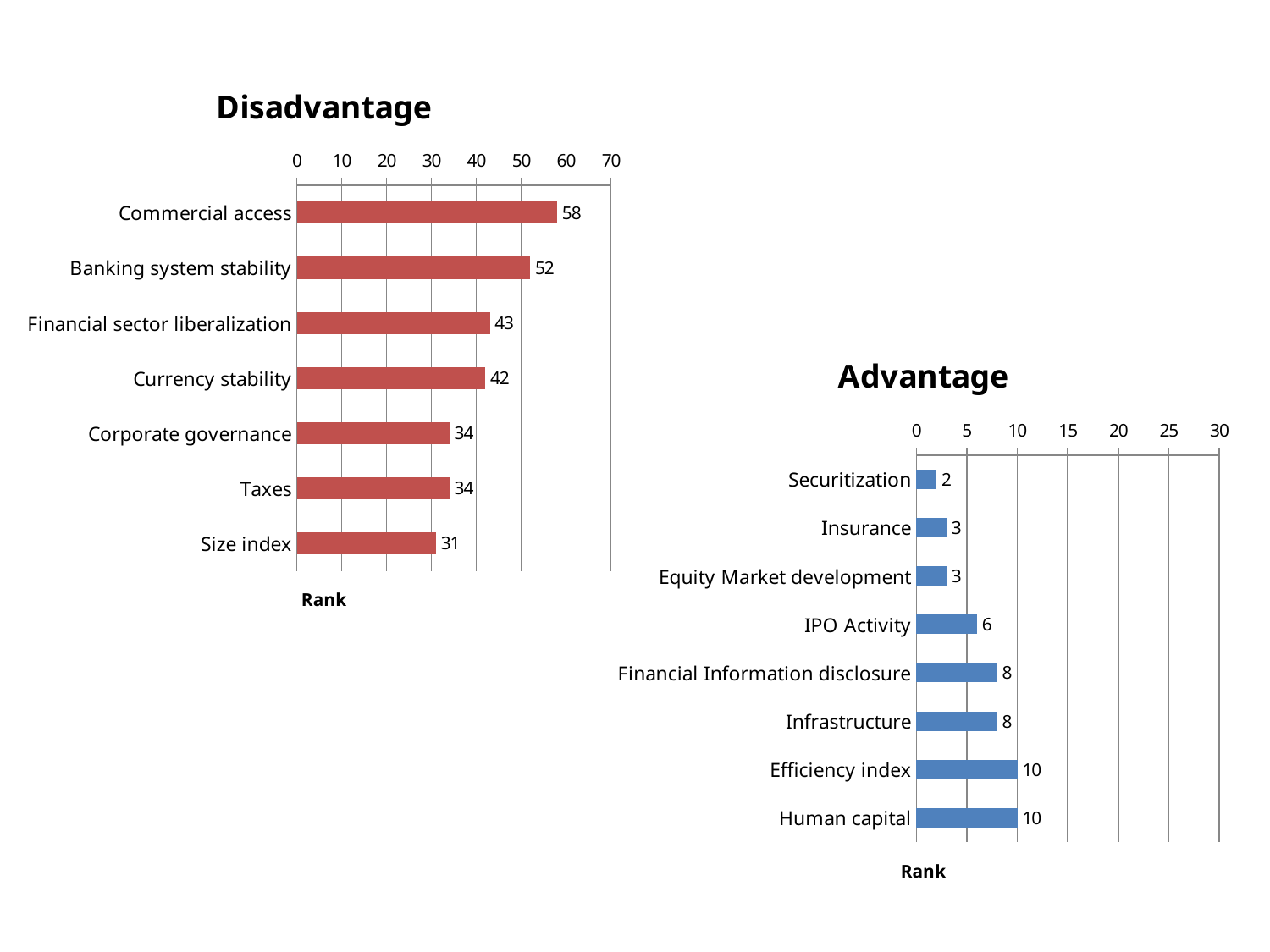
In the Advantage chart, what is the difference between the ranks for Human capital and Securitization? 8 In the Advantage chart, how many categories are shown? 8 In the Advantage chart, which is larger, the rank for Infrastructure or the rank for Insurance? Infrastructure In the Advantage chart, which category has the lowest rank? Securitization In the Disadvantage chart, is the rank for Financial sector liberalization greater or less than 40? greater In the Disadvantage chart, how many categories are shown? 7 What kind of chart is the Advantage chart? Bar chart In the Disadvantage chart, which category has the lowest rank? Size index In the Disadvantage chart, what is the rank for Commercial access? 58 In the Disadvantage chart, what is the rank for Currency stability? 42 In the Advantage chart, what is the rank for IPO Activity? 6 In the Disadvantage chart, what is the difference between the ranks for Commercial access and Banking system stability? 6